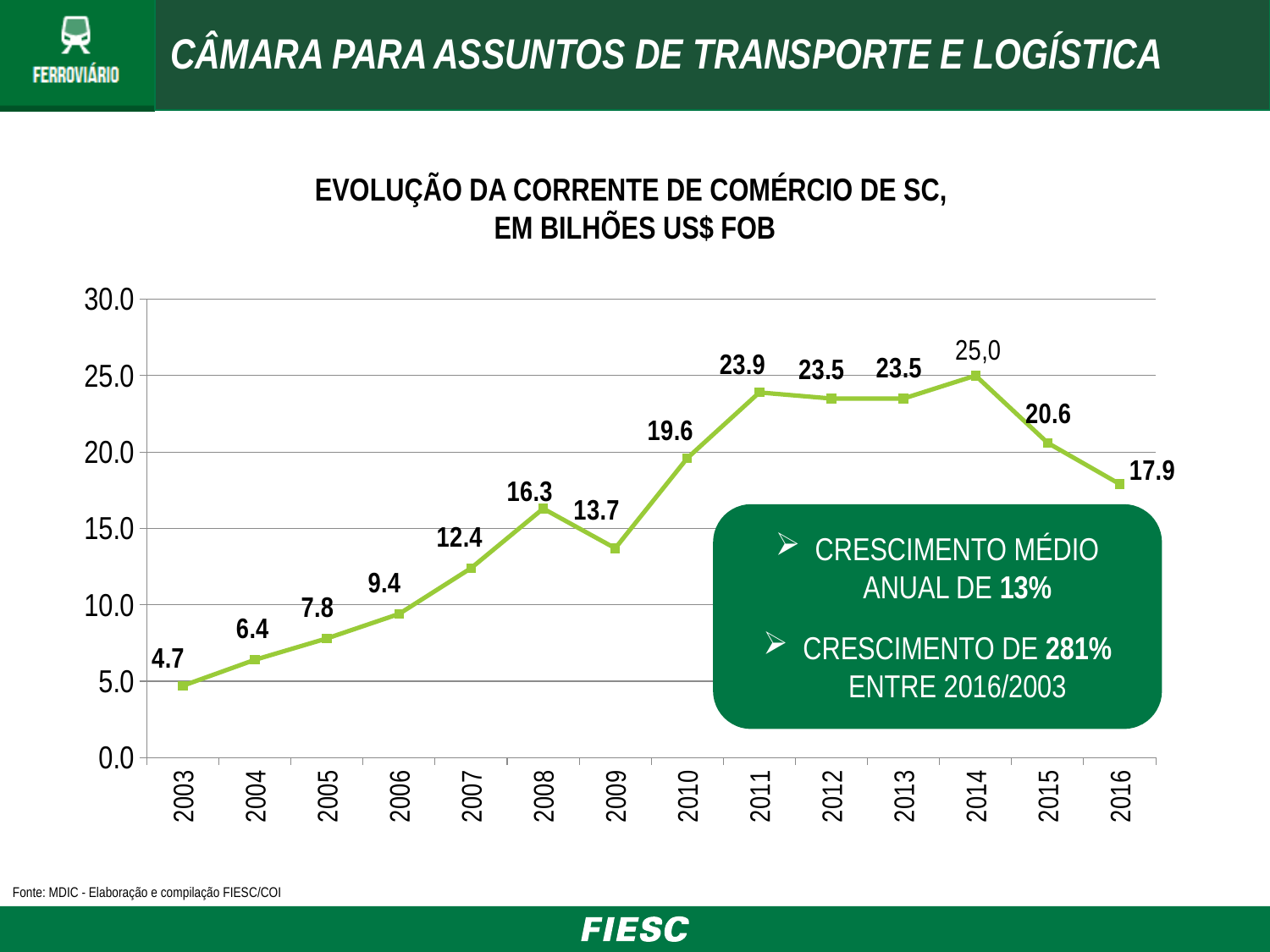
What is the difference between the values for 2008 and 2009? 2.6 Do the values rise or fall from 2003 to 2008? rise Which year has the highest value? 2014 What kind of chart is shown? line chart What is the value for 2016? 17.9 How many years are plotted on the x axis? 14 What is the value for 2010? 19.6 Which year has the lowest value? 2003 What is the value for 2003? 4.7 What is the title of the chart? EVOLUÇÃO DA CORRENTE DE COMÉRCIO DE SC, EM BILHÕES US$ FOB Is the value for 2007 greater or less than 10.0? greater Which is larger, the value for 2011 or the value for 2015? 2011